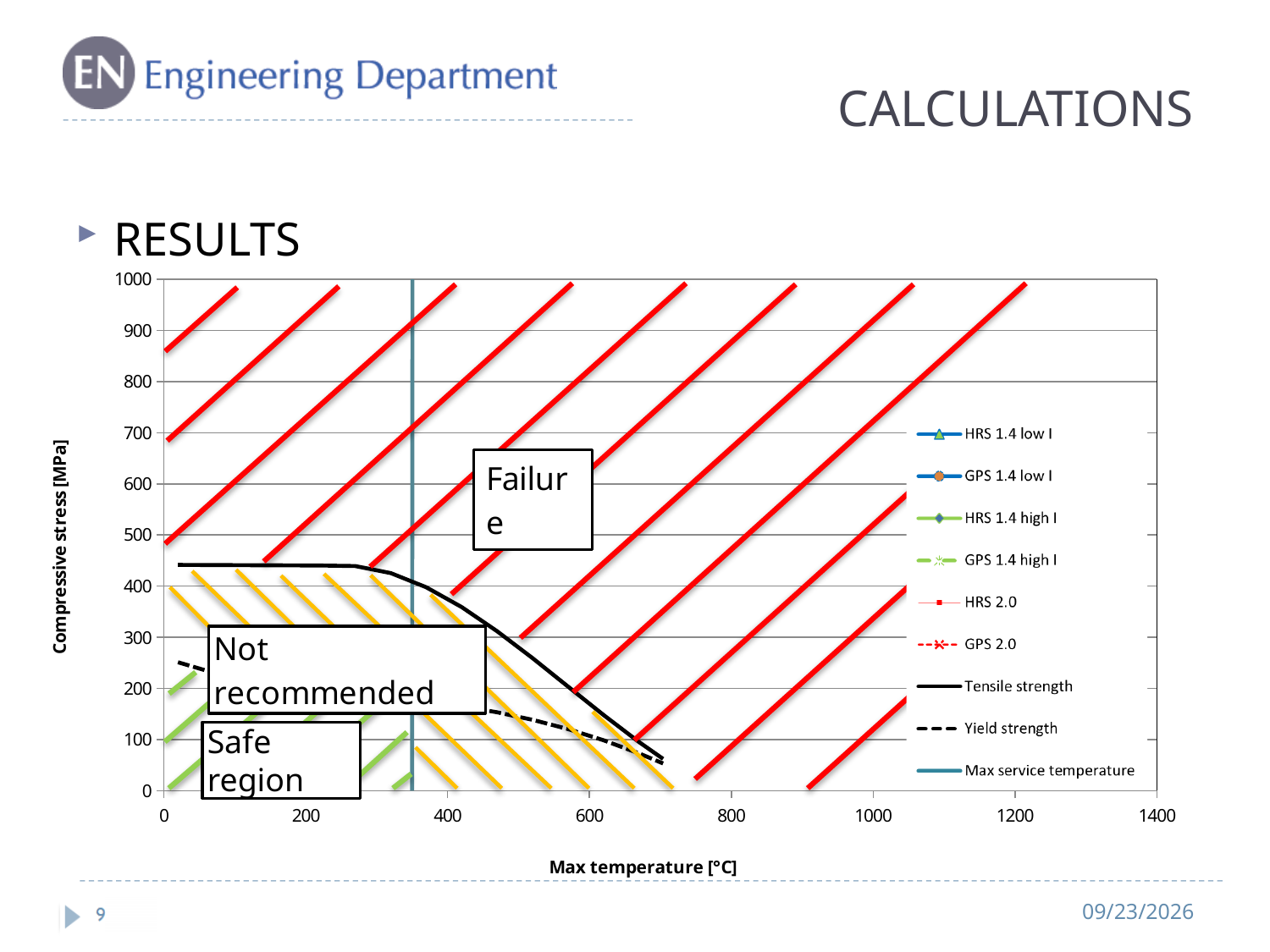
What kind of chart is shown on the slide? line chart Is the Yield strength value at 500 °C greater or less than 100 MPa? greater What is the highest value shown on the y axis of the chart? 1000 Is the Tensile strength value at 700 °C greater or less than 100 MPa? less What is the label of the y axis of the chart? Compressive stress [MPa] What is the label of the x axis of the chart? Max temperature [°C] At 600 °C, which is larger: Tensile strength or Yield strength? Tensile strength Is the Tensile strength value at 200 °C greater or less than 400 MPa? greater Does the Tensile strength curve rise or fall as the temperature increases from 300 °C to 700 °C? fall How many series does the chart legend list? 9